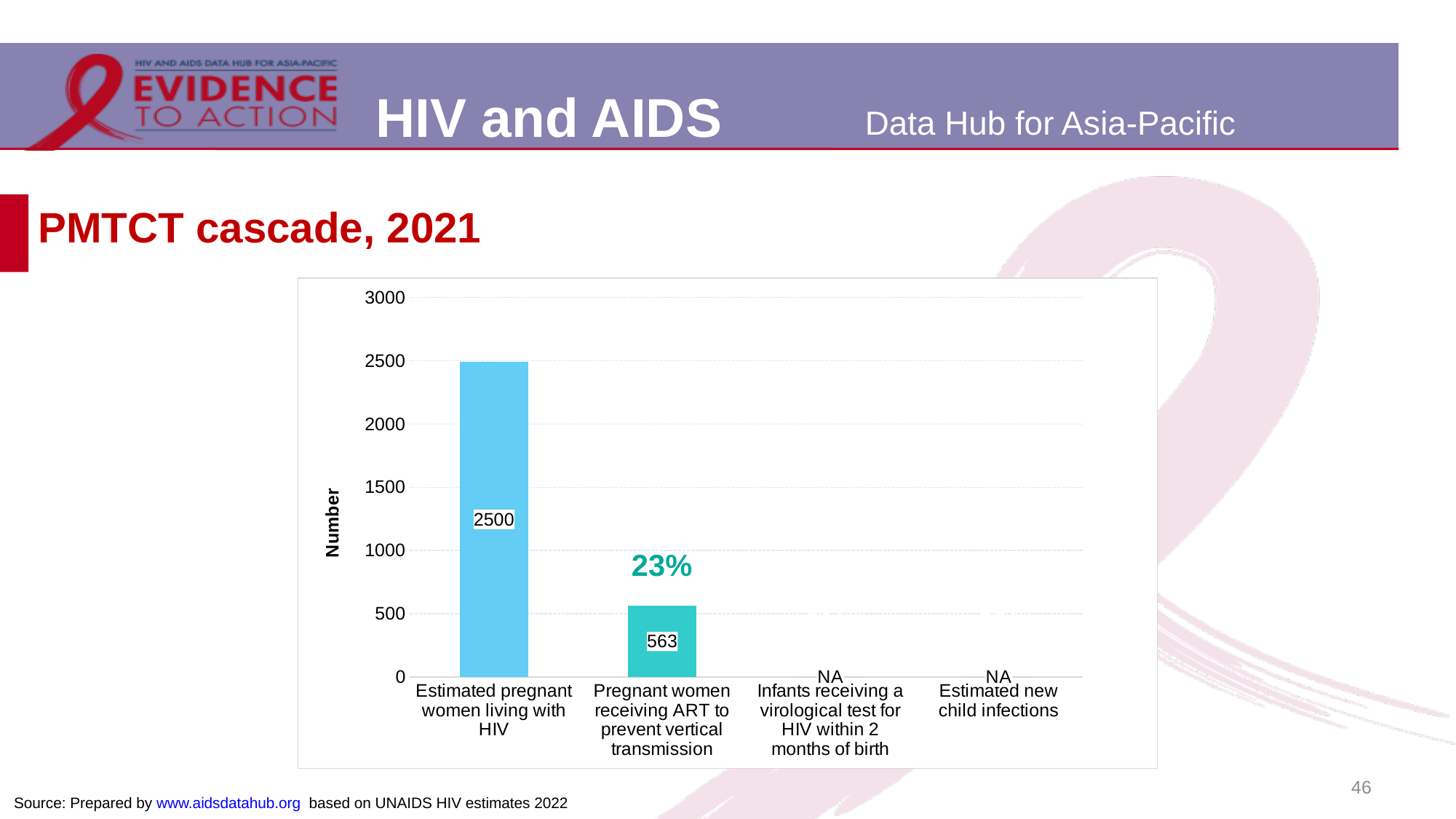
Which is larger: Estimated pregnant women living with HIV or Pregnant women receiving ART to prevent vertical transmission? Estimated pregnant women living with HIV Is the value for Pregnant women receiving ART to prevent vertical transmission greater or less than 1000? less What is the value shown for Estimated new child infections? NA What is the title of the chart? PMTCT cascade, 2021 What percentage is printed above the Pregnant women receiving ART bar? 23% What is the value for Estimated pregnant women living with HIV? 2500 How many categories are shown on the x axis? 4 Which category has the highest value? Estimated pregnant women living with HIV What kind of chart is shown? Bar chart What is the difference between Estimated pregnant women living with HIV and Pregnant women receiving ART to prevent vertical transmission? 1937 What is the value shown for Infants receiving a virological test for HIV within 2 months of birth? NA What is the value for Pregnant women receiving ART to prevent vertical transmission? 563